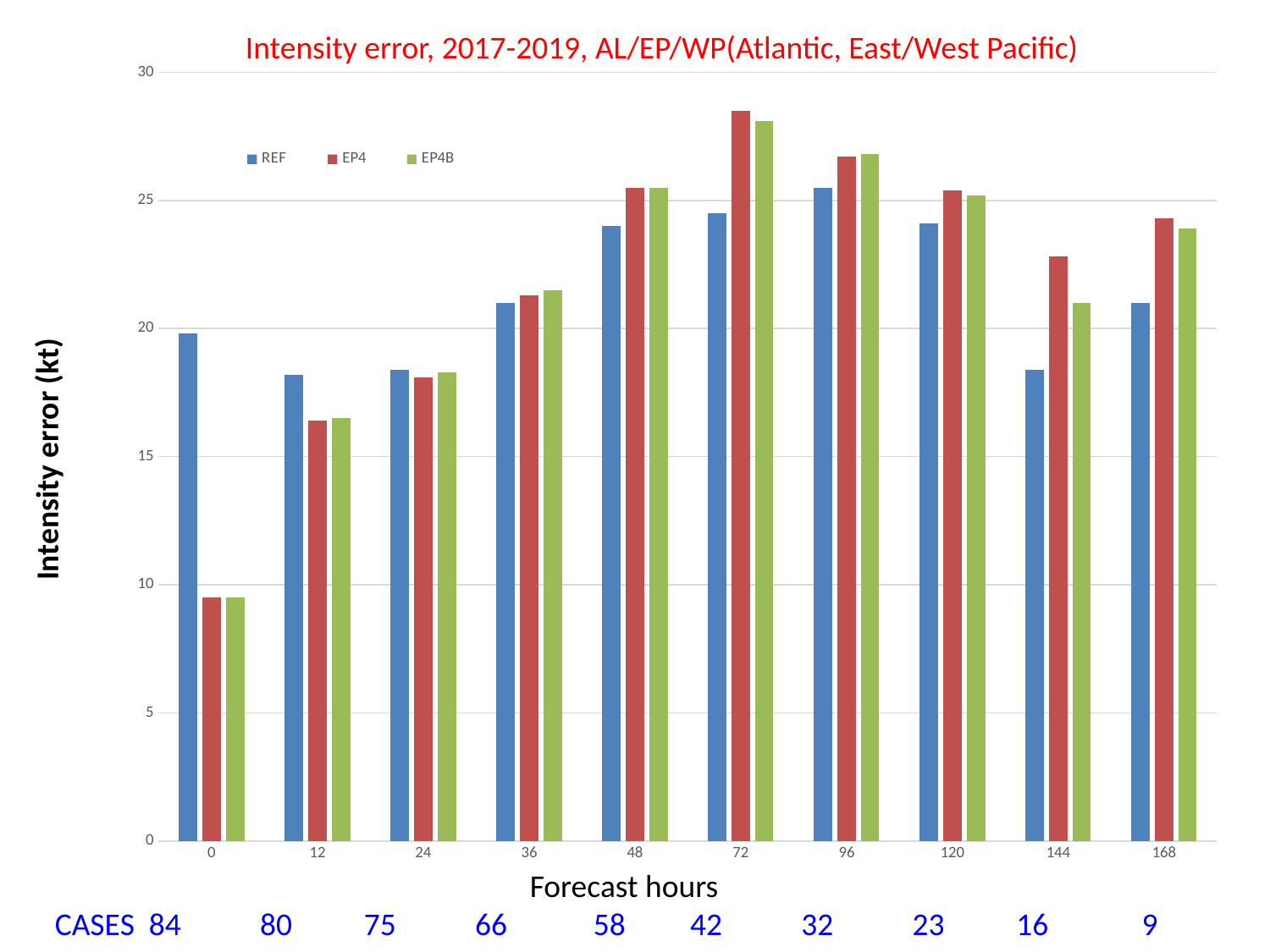
At which forecast hour is the EP4 intensity error highest? 72 At which forecast hour is the EP4 intensity error lowest? 0 At forecast hour 144, which is larger, REF or EP4? EP4 What kind of chart is shown on the slide? bar chart Is the EP4 value at forecast hour 0 greater or less than 10? less How many forecast hour categories are shown on the x axis? 10 What is the title of the chart? Intensity error, 2017-2019, AL/EP/WP(Atlantic, East/West Pacific) Is the EP4 value at forecast hour 72 greater or less than 25? greater Is the REF value at forecast hour 0 greater or less than 15? greater Does the EP4 intensity error rise or fall from forecast hour 0 to forecast hour 72? rise At forecast hour 0, which is larger, REF or EP4B? REF How many series does the legend list? 3